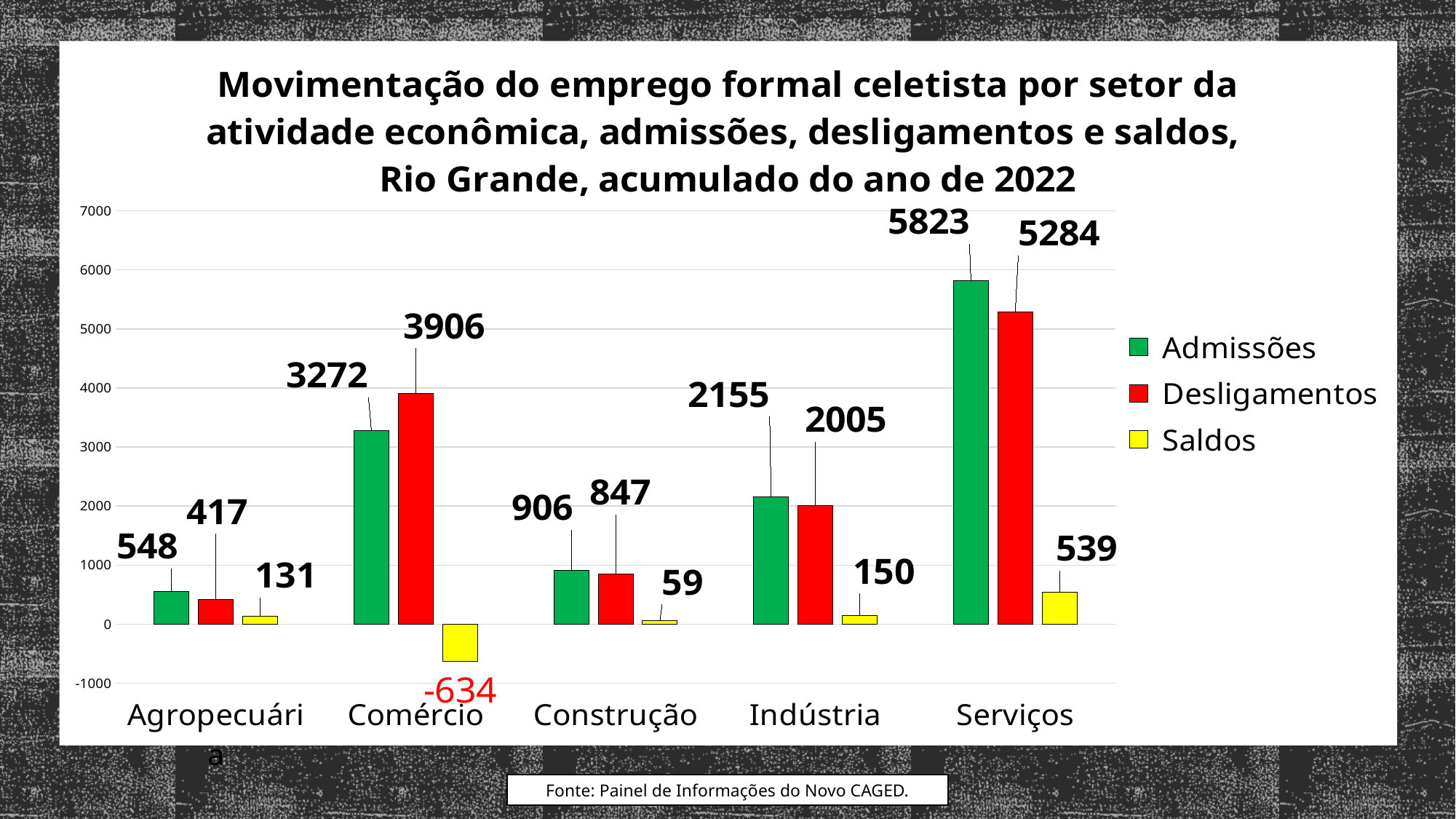
How many sectors are shown on the x axis? 5 Which is larger for Comércio, Admissões or Desligamentos? Desligamentos What kind of chart is shown on the slide? Bar chart What is the value of Desligamentos for Comércio? 3906 What is the value of Saldos for Construção? 59 What is the difference between Admissões and Desligamentos for Indústria? 150 Which sector has the lowest value for Desligamentos? Agropecuária What is the value of Saldos for Comércio? -634 How many series does the legend list? 3 Which sector has the highest value for Admissões? Serviços What is the value of Admissões for Serviços? 5823 What colour represents the Saldos series? Yellow